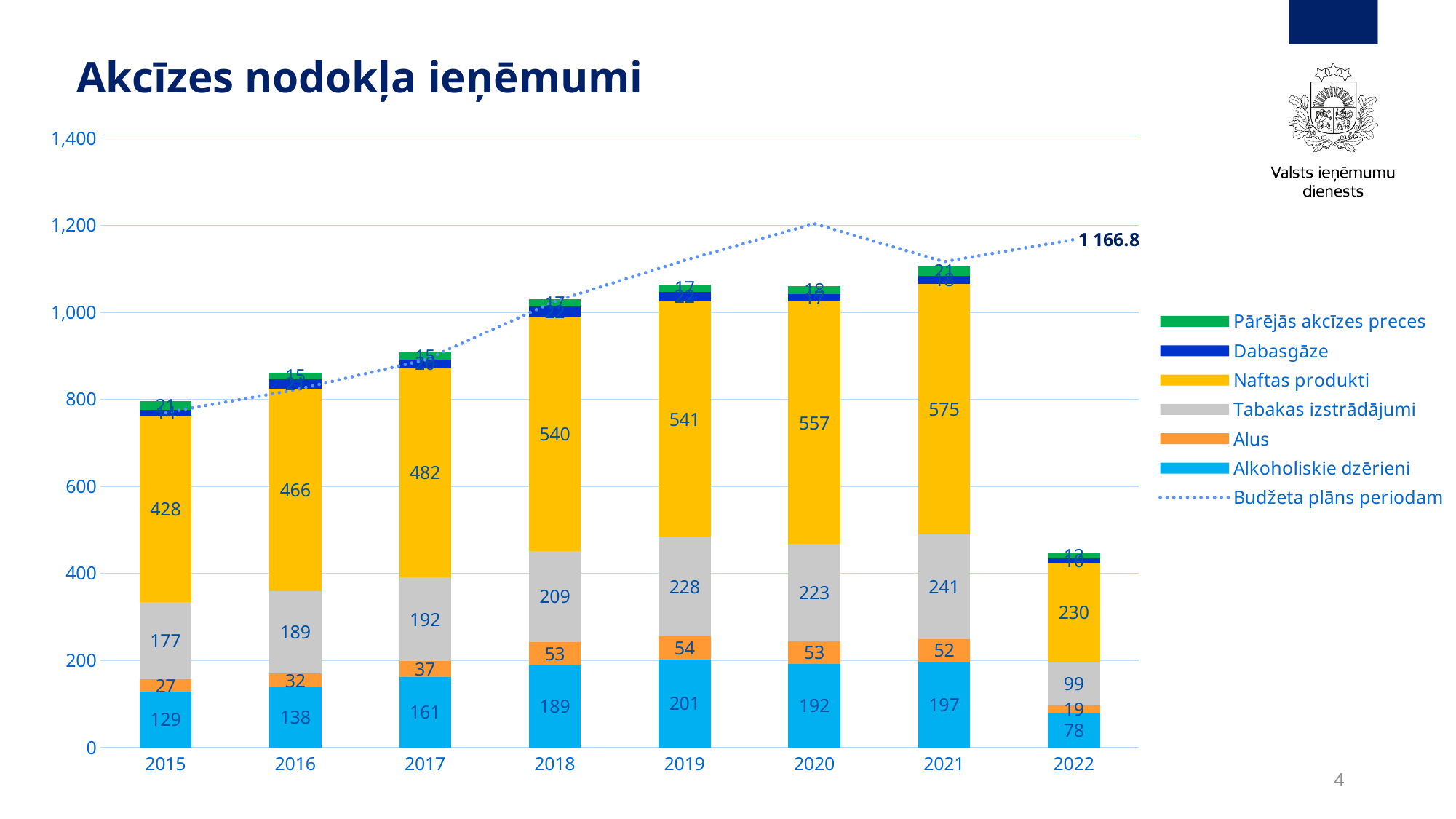
How many years are shown on the x axis? 8 Which is larger, the Tabakas izstrādājumi value for 2019 or for 2020? 2019 In which year is the Naftas produkti value highest? 2021 What value is labelled on the Budžeta plāns periodam line at 2022? 1 166.8 What is the difference between the Naftas produkti values for 2021 and 2015? 147 Is the total height of the 2022 bar greater or less than 600? less What is the value for Alkoholiskie dzērieni in 2019? 201 What is the value for Tabakas izstrādājumi in 2018? 209 How many series does the legend list? 7 In which year is the Tabakas izstrādājumi value lowest? 2022 What is the value for Naftas produkti in 2021? 575 What kind of chart is shown on the slide? stacked bar chart with a line